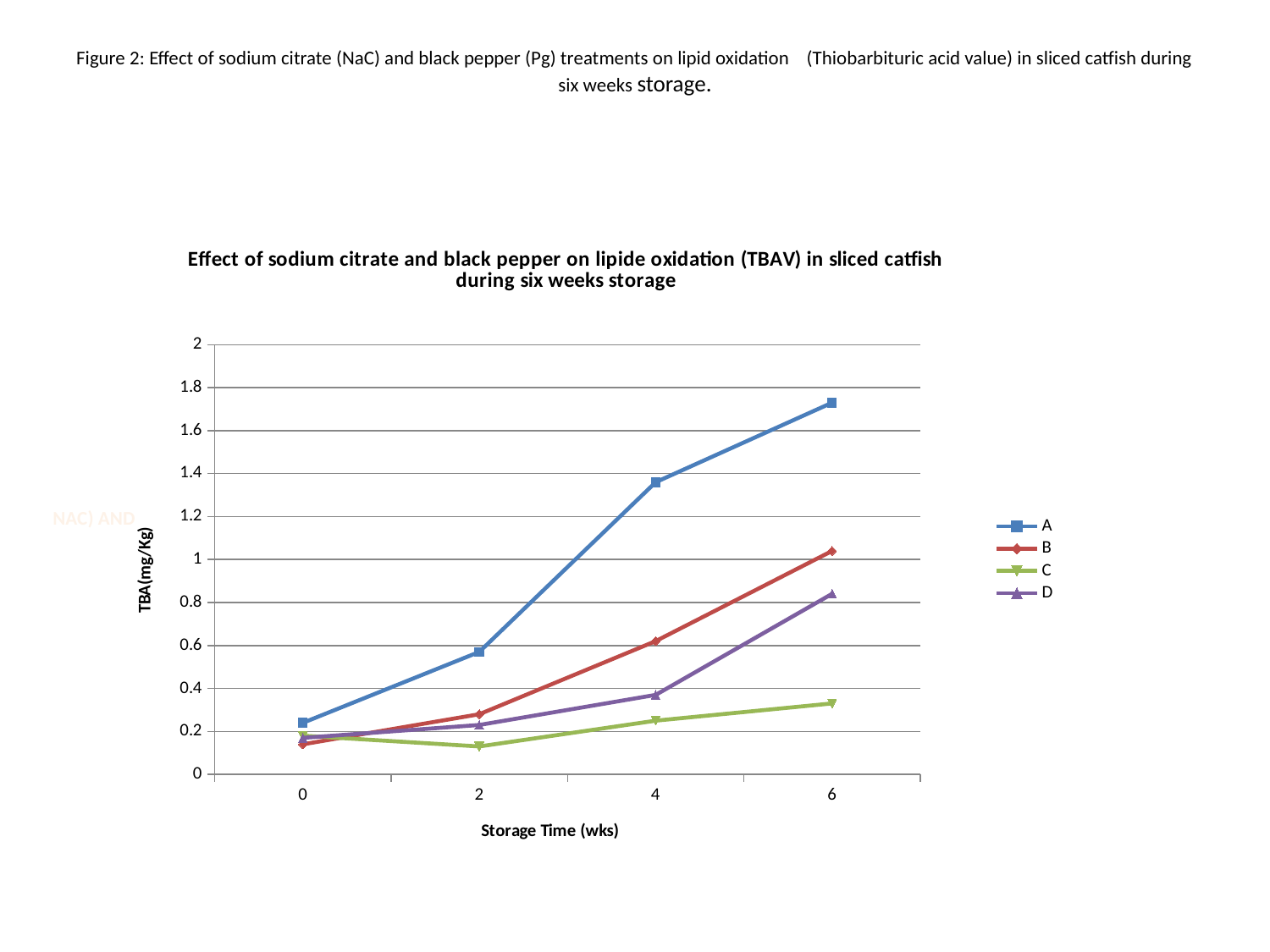
How many series does the legend list? 4 Is the value for series D at 6 weeks greater or less than 1? less Do the values for series A rise or fall as storage time increases from 0 to 6 weeks? rise Which series has the highest TBA value at 6 weeks? A What is the title of the y axis? TBA(mg/Kg) Is the value for series A at 6 weeks greater or less than 1.6? greater At 4 weeks, which series has the larger value, A or B? A How many storage time points are plotted along the x axis? 4 Is the value for series C at 6 weeks greater or less than 0.4? less Which series has the lowest TBA value at 6 weeks? C What kind of chart is shown on the slide? line chart